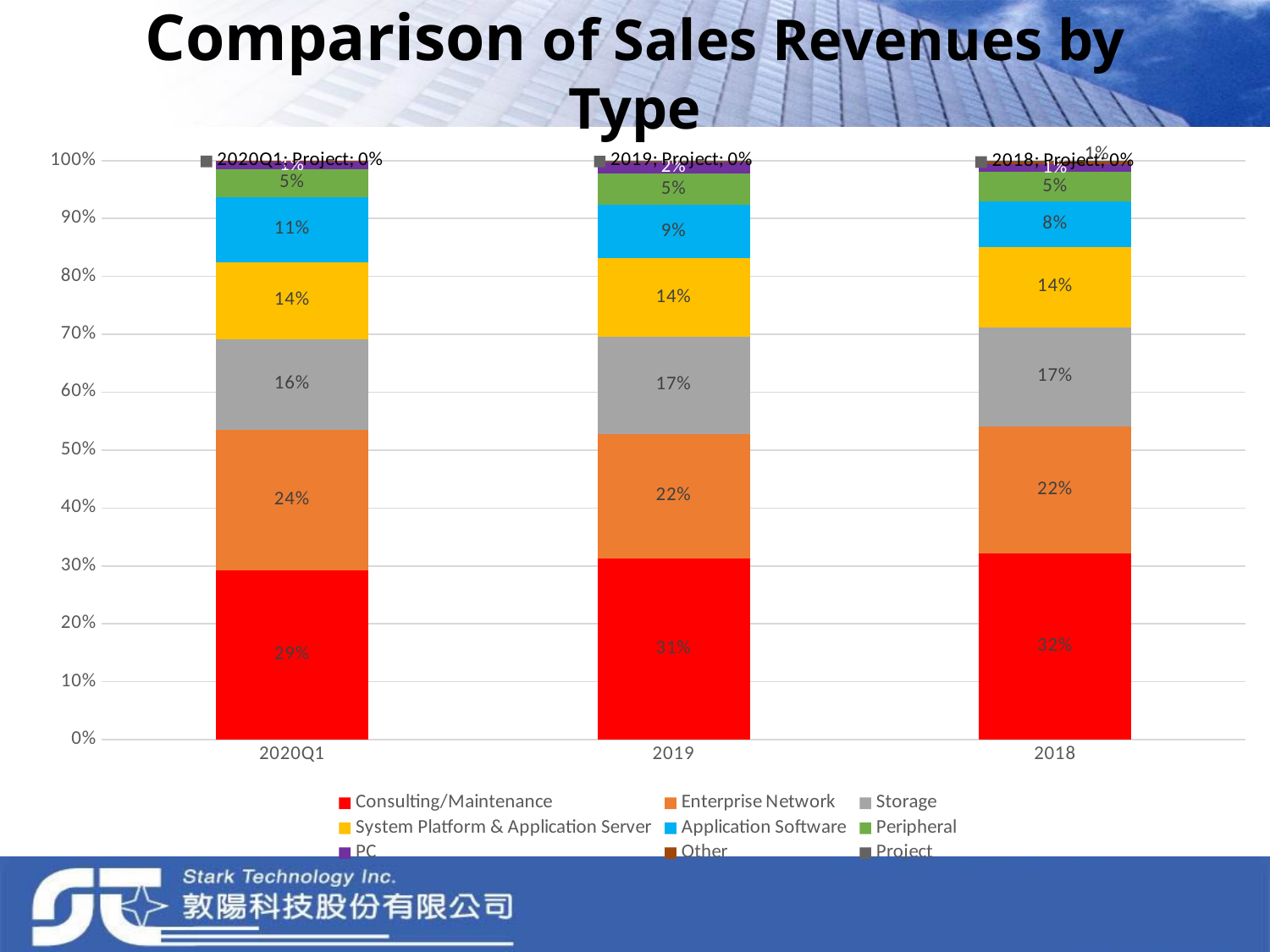
What is the Enterprise Network share of sales revenue in 2019? 22% Which period has the lowest Application Software share? 2018 What is the title of the chart? Comparison of Sales Revenues by Type Is the Enterprise Network share larger in 2020Q1 or in 2019? 2020Q1 How many periods are shown on the x axis? 3 What type of chart is shown on the slide? Stacked bar chart How many series does the legend list? 9 What is the difference between the Consulting/Maintenance share in 2018 and in 2020Q1? 3% What is the Application Software share of sales revenue in 2018? 8% What is the Consulting/Maintenance share of sales revenue in 2020Q1? 29% Which period has the highest Consulting/Maintenance share? 2018 What is the Storage share of sales revenue in 2020Q1? 16%